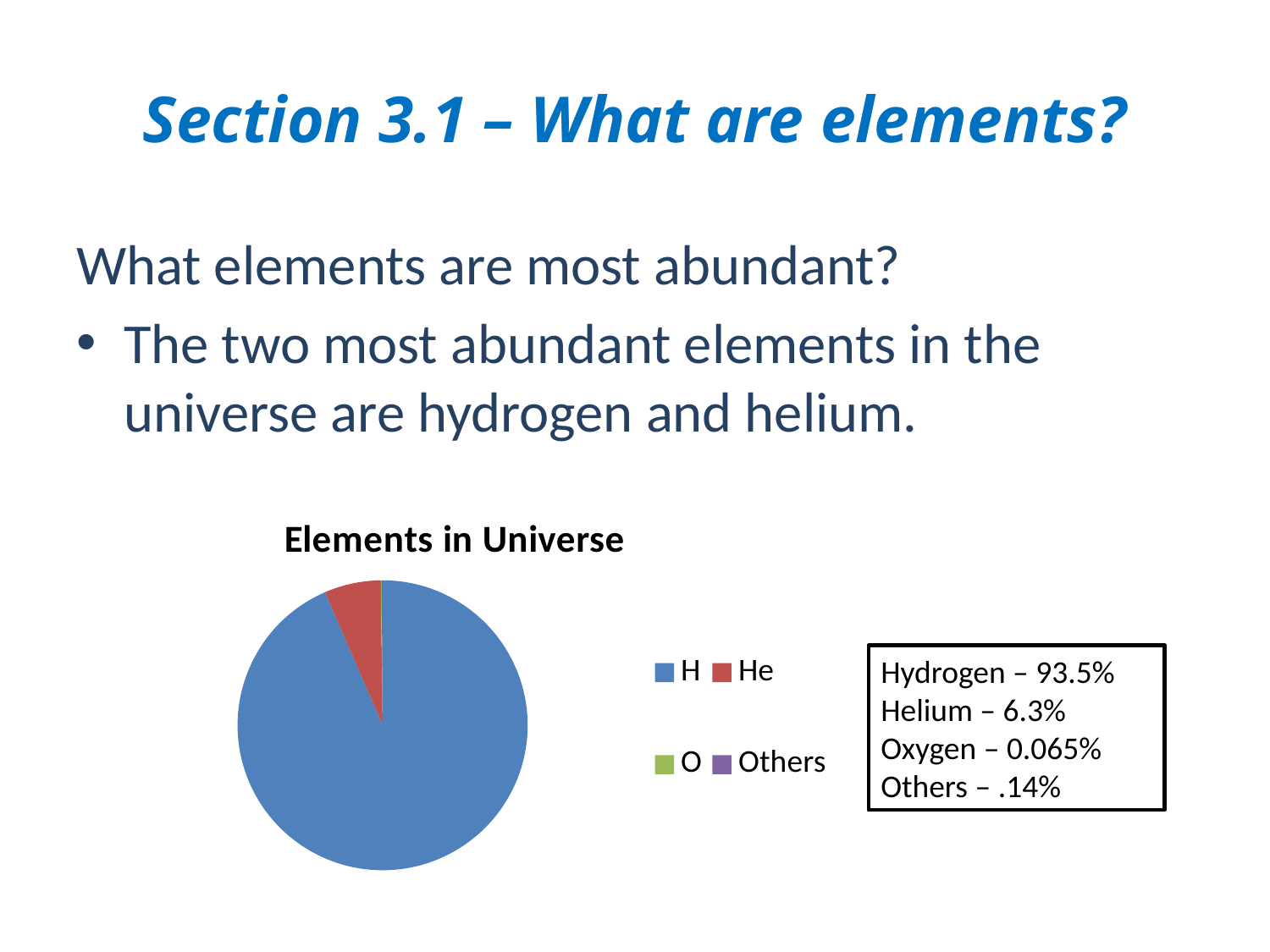
According to the slide, what percentage of the universe's elements is helium? 6.3% Which slice is larger, H or He? H Which element has the largest slice in the pie chart? H According to the slide, what percentage of the universe's elements is oxygen? 0.065% According to the slide, what percentage of the universe's elements is hydrogen? 93.5% What is the difference in percentage points between hydrogen and helium? 87.2 Which element has the smallest share according to the percentages listed on the slide? Oxygen What is the title of the chart? Elements in Universe According to the slide, what percentage of the universe's elements is 'Others'? .14% How many entries does the chart's legend list? 4 What colour is the H slice in the pie chart? blue What kind of chart is shown on the slide? pie chart